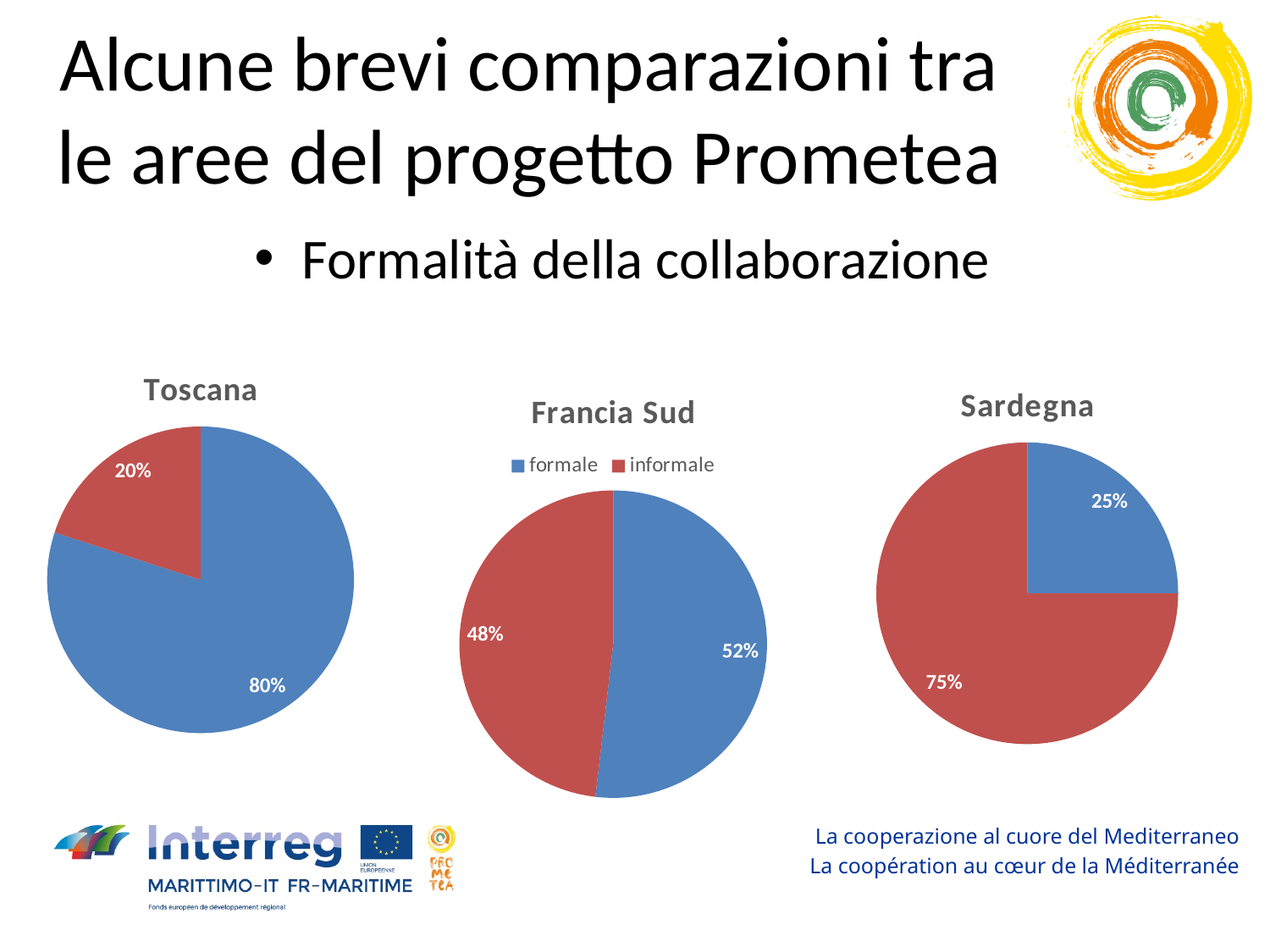
In the Sardegna chart, what percentage is shown for the blue (formale) slice? 25% In the Sardegna chart, what percentage is shown for the red (informale) slice? 75% In the Francia Sud chart, what share is labelled for formale? 52% In the Toscana chart, what percentage is shown for the blue (formale) slice? 80% What kind of chart is used for Francia Sud? pie chart How many pie charts are shown on the slide? 3 In the Toscana chart, what is the difference between the two slices' percentages? 60% In the Sardegna chart, which slice is the largest? informale (75%) In the Francia Sud chart, what share is labelled for informale? 48% How many entries does the legend on the Francia Sud chart list? 2 In the Toscana chart, which slice is larger, the blue one or the red one? the blue one In the Toscana chart, what percentage is shown for the red (informale) slice? 20%